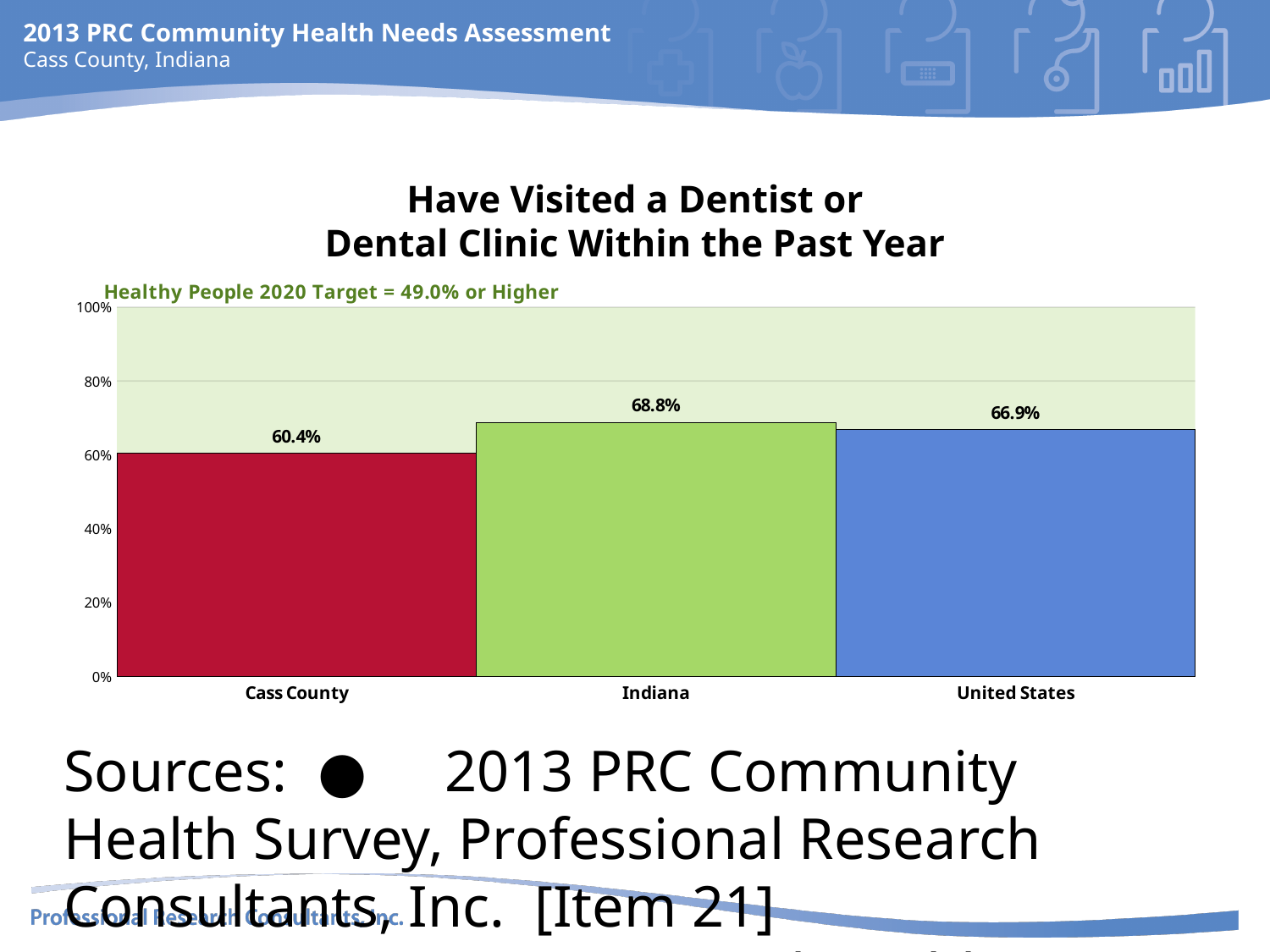
What is the value for Indiana? 68.8% Which category has the lowest value? Cass County What is the value for the United States? 66.9% How many categories are shown in the chart? 3 What kind of chart is shown on the slide? bar chart What is the value for Cass County? 60.4% What is the difference between the values for the United States and Cass County? 6.5% What is the difference between the values for Indiana and Cass County? 8.4% What is the Healthy People 2020 Target stated on the chart? 49.0% or Higher Which is larger, the value for Indiana or the value for the United States? Indiana Is the value for Cass County greater or less than 80%? less Which category has the highest value? Indiana